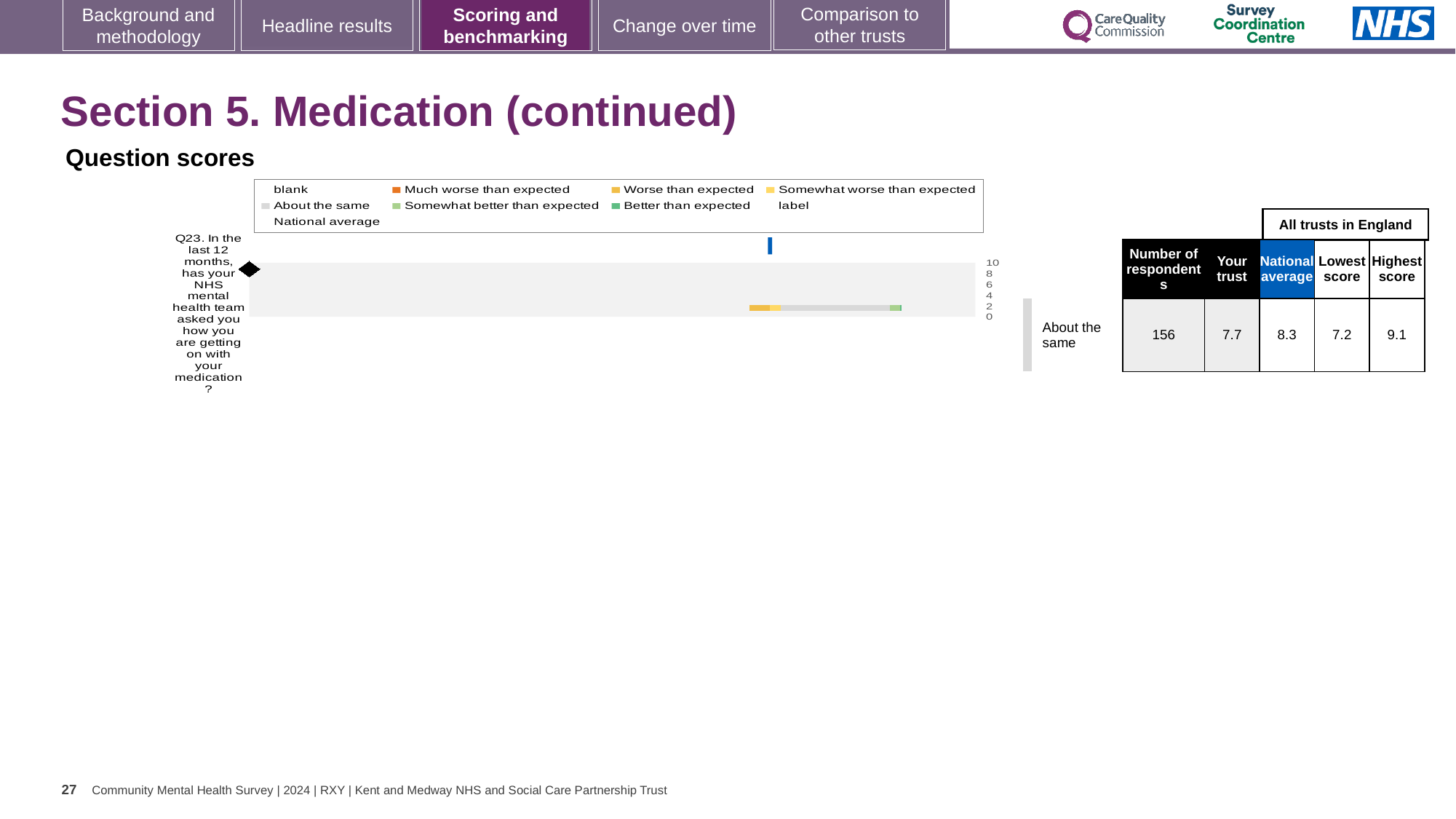
What is the difference between the highest and lowest trust scores for Q23? 1.9 What kind of chart is used to show the Q23 question score? Bar chart How many respondents answered Q23? 156 Which is larger for Q23, the trust's score or the national average? National average What is the 'Your trust' score for Q23 (asked how you are getting on with your medication)? 7.7 What is the highest score among all trusts in England for Q23? 9.1 By how much does the national average exceed the trust's score for Q23? 0.6 How many survey questions are plotted on the chart? 1 What is the national average score for Q23? 8.3 What benchmark category is the trust's Q23 score placed in? About the same What is the maximum value shown on the chart's score axis? 10 What is the lowest score among all trusts in England for Q23? 7.2